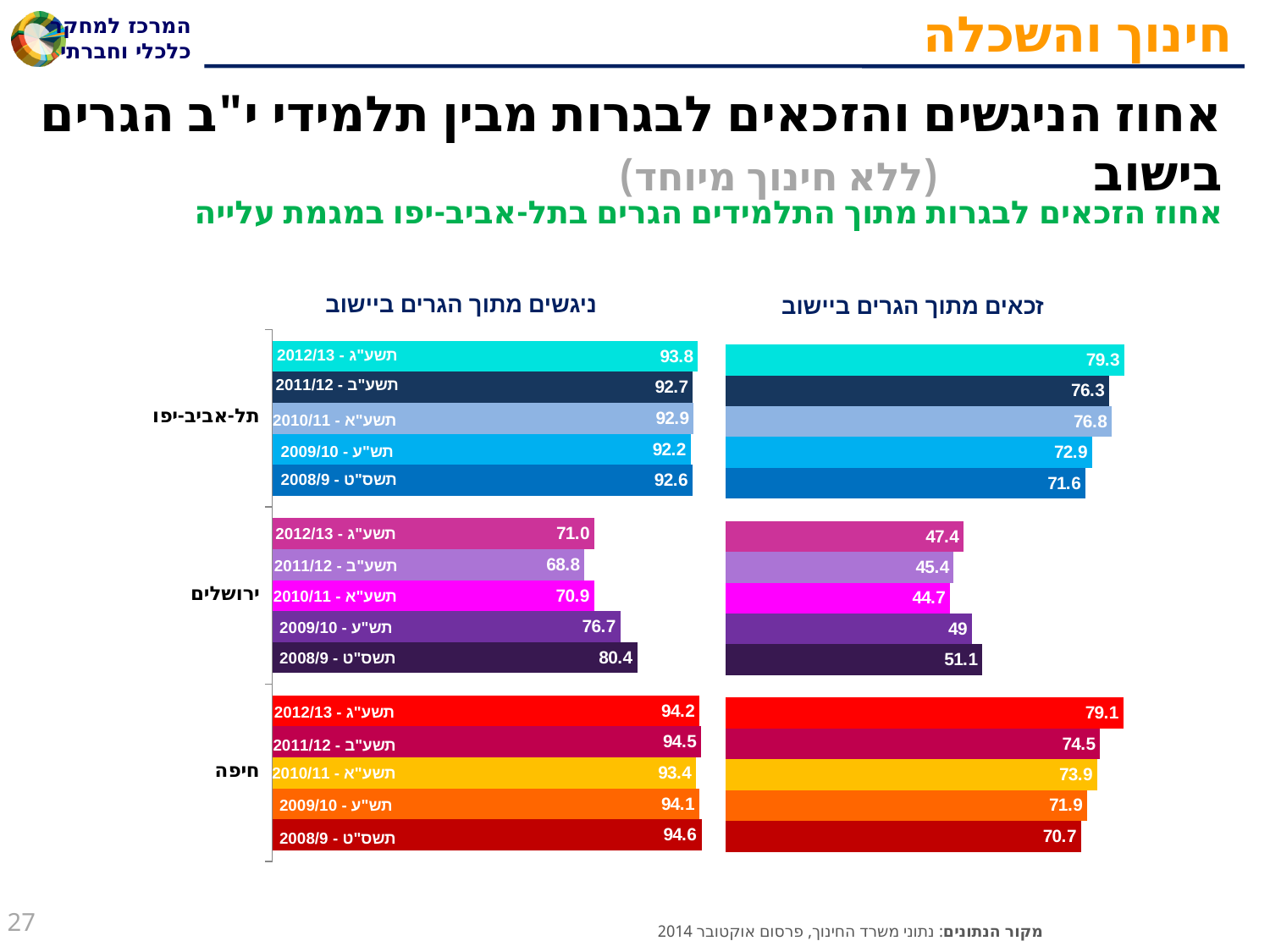
In the left chart (ניגשים מתוך הגרים ביישוב), which is larger for תשע"ג - 2012/13: the value for תל-אביב-יפו or the value for חיפה? חיפה What kind of chart is the right chart (זכאים מתוך הגרים ביישוב)? bar chart In the left chart (ניגשים מתוך הגרים ביישוב), which year has the highest value for חיפה? תשס"ט - 2008/9 How many bars are shown for each city in the left chart (ניגשים מתוך הגרים ביישוב)? 5 In the right chart (זכאים מתוך הגרים ביישוב), which year has the lowest value for ירושלים? תשע"א - 2010/11 In the right chart (זכאים מתוך הגרים ביישוב), do the values for ירושלים rise or fall from תשס"ט - 2008/9 to תשע"א - 2010/11? fall In the left chart (ניגשים מתוך הגרים ביישוב), what is the value for ירושלים in תשס"ט - 2008/9? 80.4 How many cities are shown in the left chart (ניגשים מתוך הגרים ביישוב)? 3 In the right chart (זכאים מתוך הגרים ביישוב), what is the difference between the תל-אביב-יפו values for תשע"ג - 2012/13 and תשס"ט - 2008/9? 7.7 In the right chart (זכאים מתוך הגרים ביישוב), what is the value for תל-אביב-יפו in תשע"ג - 2012/13? 79.3 In the left chart (ניגשים מתוך הגרים ביישוב), what is the value for חיפה in תשע"א - 2010/11? 93.4 In the right chart (זכאים מתוך הגרים ביישוב), what is the value for ירושלים in תש"ע - 2009/10? 49